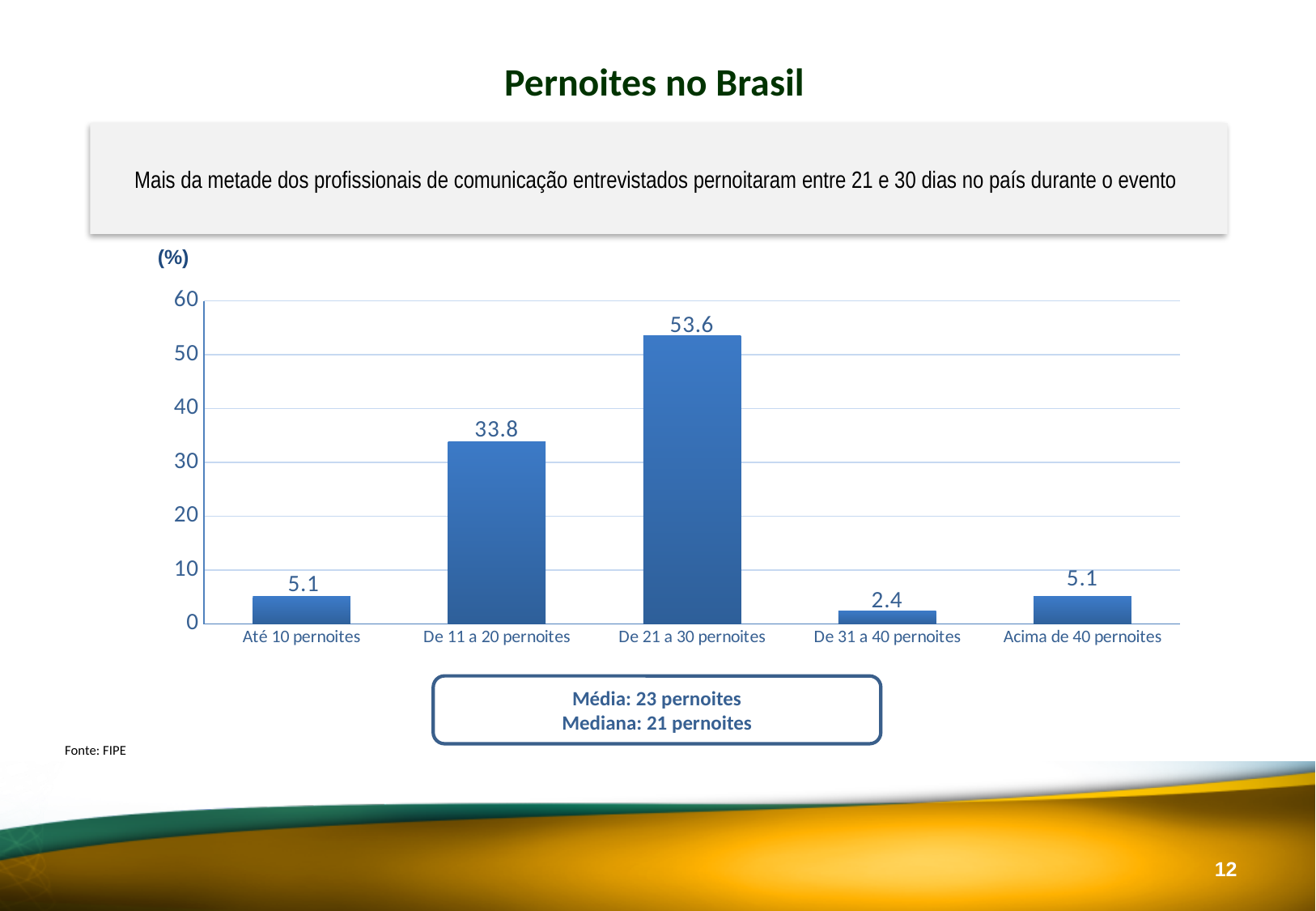
What is the value for "De 31 a 40 pernoites"? 2.4 How many categories are shown on the x axis? 5 Which category has the lowest value? De 31 a 40 pernoites What is the value for "De 21 a 30 pernoites"? 53.6 What is the difference between the values for "De 21 a 30 pernoites" and "De 11 a 20 pernoites"? 19.8 Which category has the highest value? De 21 a 30 pernoites What is the value for "Até 10 pernoites"? 5.1 Is the value for "De 21 a 30 pernoites" greater or less than 50? greater Which is larger, the value for "De 11 a 20 pernoites" or the value for "Acima de 40 pernoites"? De 11 a 20 pernoites What is the title of the slide containing the chart? Pernoites no Brasil What kind of chart is shown on the slide? bar chart What is the value for "De 11 a 20 pernoites"? 33.8